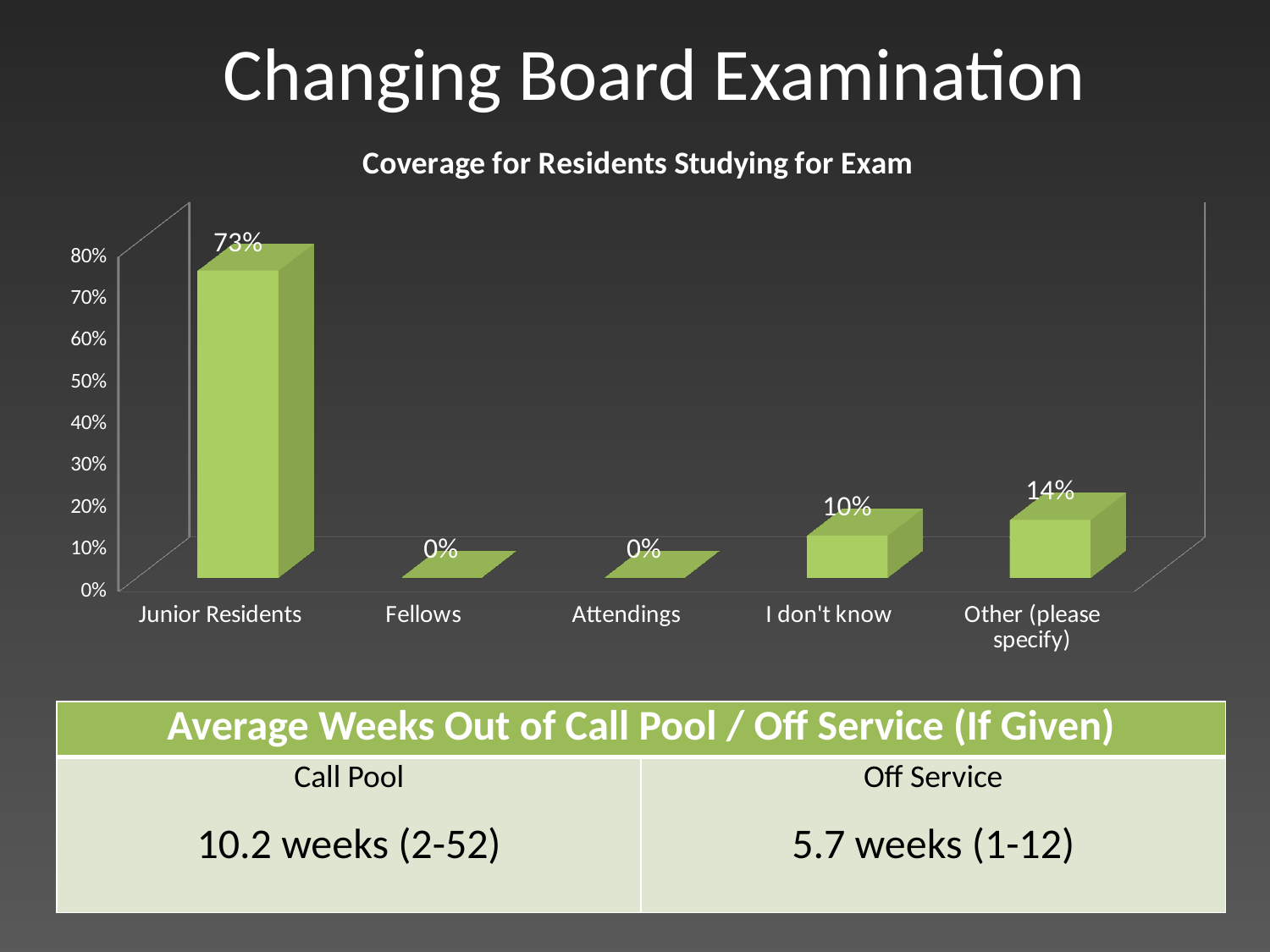
What is the value for Other (please specify)? 14% What is the difference between the values for Junior Residents and Other (please specify)? 59% What is the title of the chart? Coverage for Residents Studying for Exam What kind of chart is shown? bar chart Which category has the highest value? Junior Residents How many categories are shown on the x axis? 5 What is the value for Junior Residents? 73% Which is larger, the value for I don't know or the value for Other (please specify)? Other (please specify) What is the value for Fellows? 0% What is the value for I don't know? 10% What is the difference between the values for Other (please specify) and I don't know? 4% Is the value for Junior Residents greater or less than 70%? greater